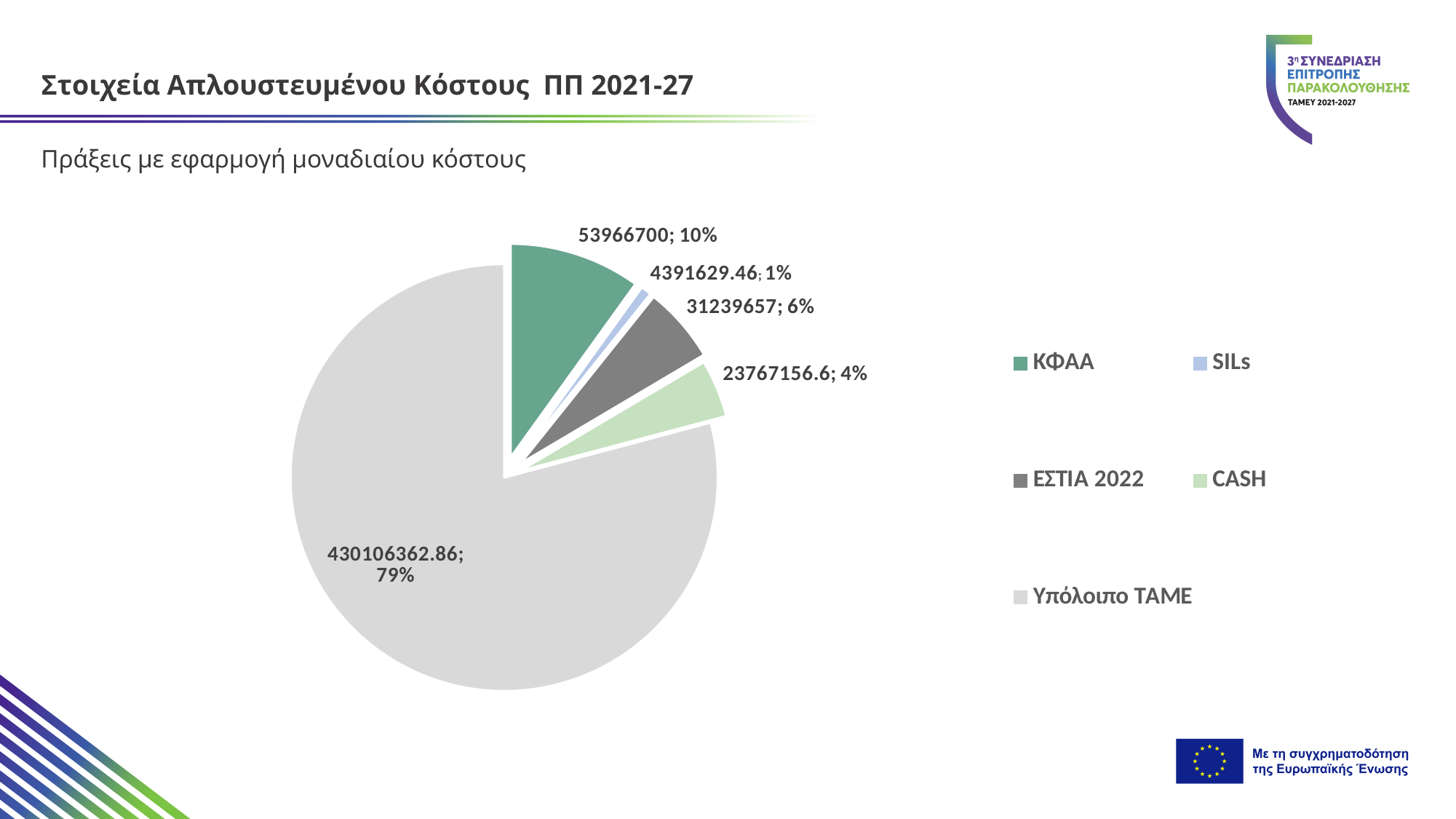
What percentage share of the pie does ΚΦΑΑ represent? 10% What is the value shown for ΕΣΤΙΑ 2022 in the pie chart? 31239657 Which category has the smallest slice in the pie chart? SILs What is the value shown for ΚΦΑΑ in the pie chart? 53966700 What kind of chart is shown on the slide? pie chart Which category has the largest slice in the pie chart? Υπόλοιπο ΤΑΜΕ How many slices does the pie chart have? 5 What is the difference between the values for ΚΦΑΑ and ΕΣΤΙΑ 2022? 22727043 What is the value shown for SILs in the pie chart? 4391629.46 What is the value shown for CASH in the pie chart? 23767156.6 Which is larger in the pie chart, ΕΣΤΙΑ 2022 or CASH? ΕΣΤΙΑ 2022 What percentage share of the pie does Υπόλοιπο ΤΑΜΕ represent? 79%